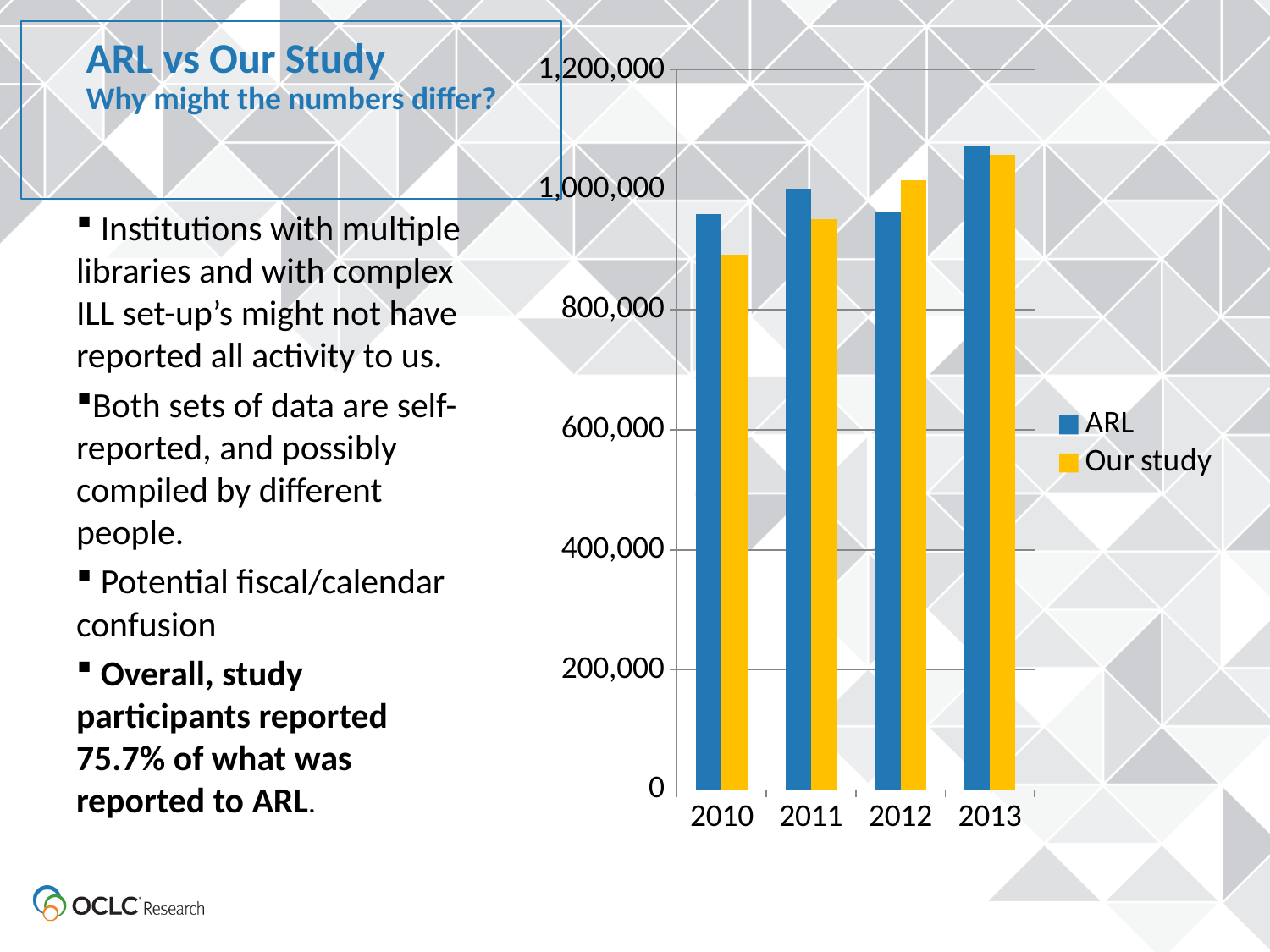
Is the ARL value for 2010 greater or less than 800,000? greater Which year has the lowest value for Our study? 2010 Do the Our study values rise or fall from 2010 to 2013? rise Which year has the highest ARL value? 2013 In 2012, which is larger, the ARL value or the Our study value? Our study In 2010, which is larger, the ARL value or the Our study value? ARL Is the Our study value for 2010 greater or less than 1,000,000? less How many series does the chart's legend list? 2 What kind of chart is shown on the slide? bar chart Which colour represents the ARL series in the chart? blue Is the ARL value for 2013 greater or less than 1,000,000? greater How many years are shown on the x axis of the chart? 4